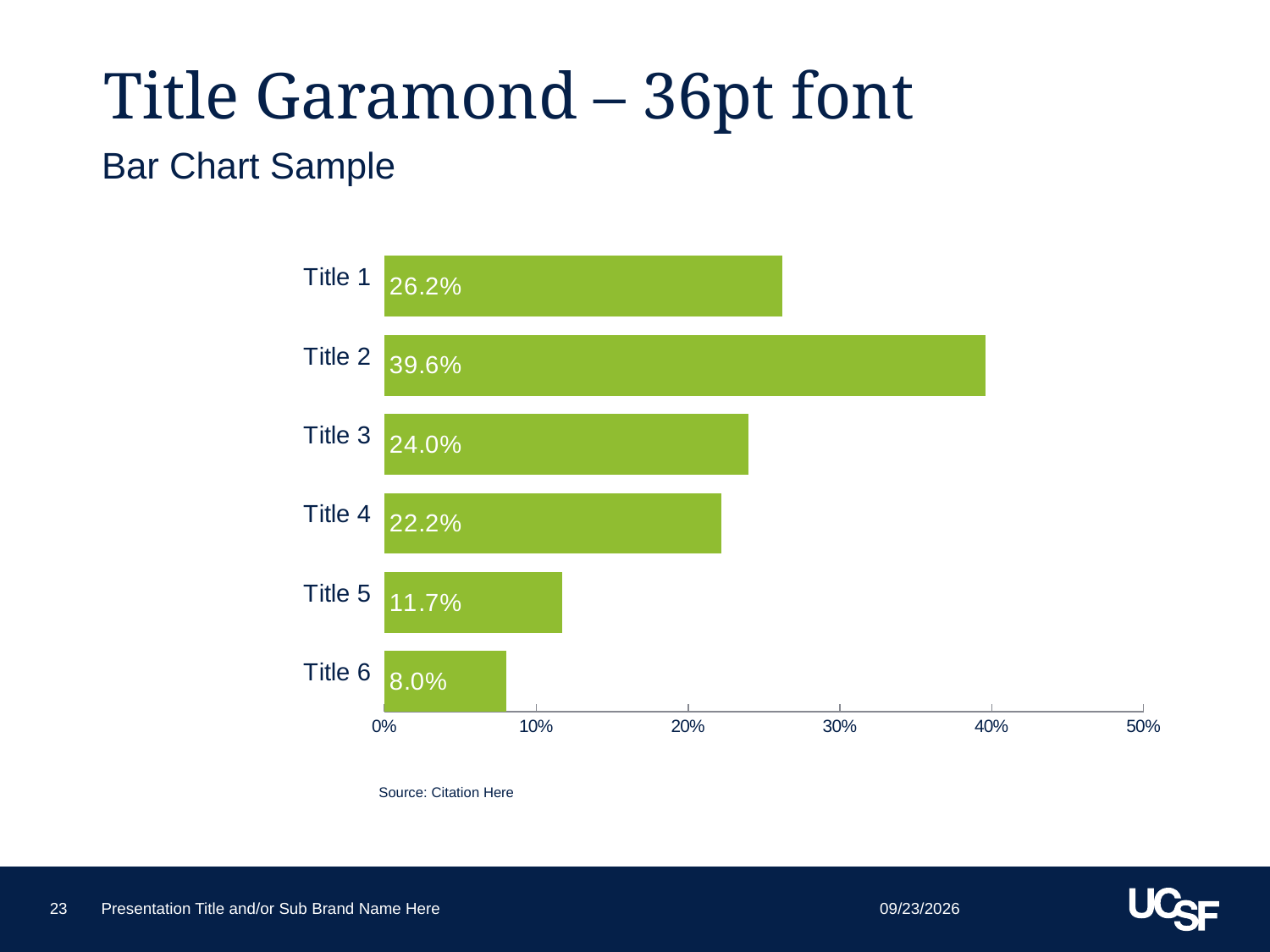
Which category has the highest value? Title 2 What is the value for Title 6? 8.0% What is the difference between the values for Title 3 and Title 4? 1.8% Which is larger, the value for Title 1 or the value for Title 3? Title 1 Which category has the lowest value? Title 6 What is the value for Title 5? 11.7% What is the difference between the values for Title 2 and Title 1? 13.4% What kind of chart is shown on the slide? Bar chart How many categories are shown in the chart? 6 What is the source text shown below the chart? Source: Citation Here Is the value for Title 4 greater or less than 20%? greater What is the value for Title 2? 39.6%